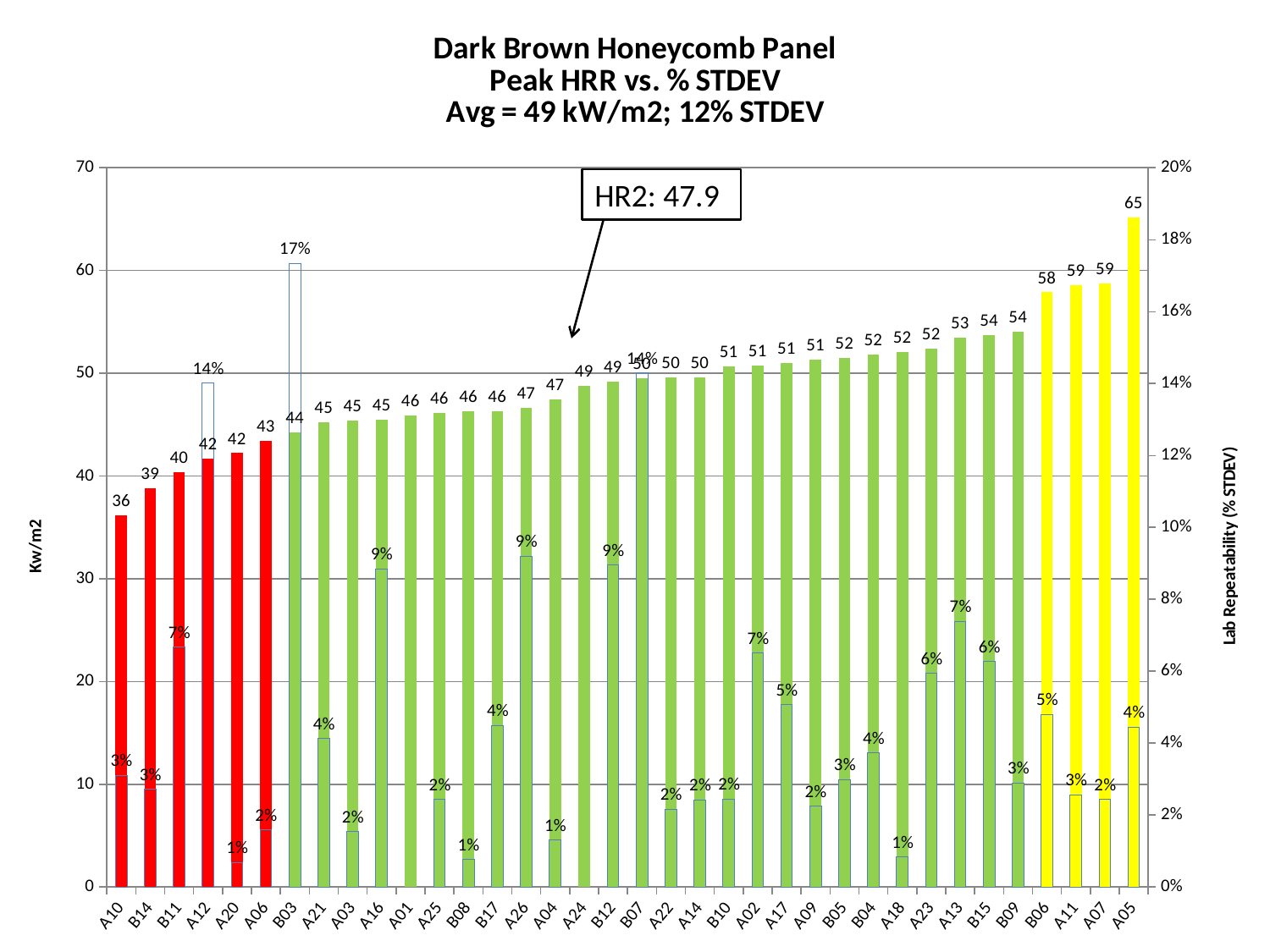
Which category has the highest % STDEV value? B03 What value is given in the HR2 annotation box on the chart? 47.9 What is the peak HRR value for A05? 65 What is the difference between the peak HRR values of A05 and A10? 29 Which category has the lowest peak HRR value? A10 What is the lab repeatability (% STDEV) value shown for B03? 17% Which category has the highest peak HRR value? A05 What kind of chart is shown on the slide? bar chart Do the peak HRR values rise or fall from left to right along the x axis? rise Which has a higher peak HRR value, B06 or A06? B06 Is the peak HRR value for A01 greater or less than 40? greater How many categories are shown on the x axis? 36